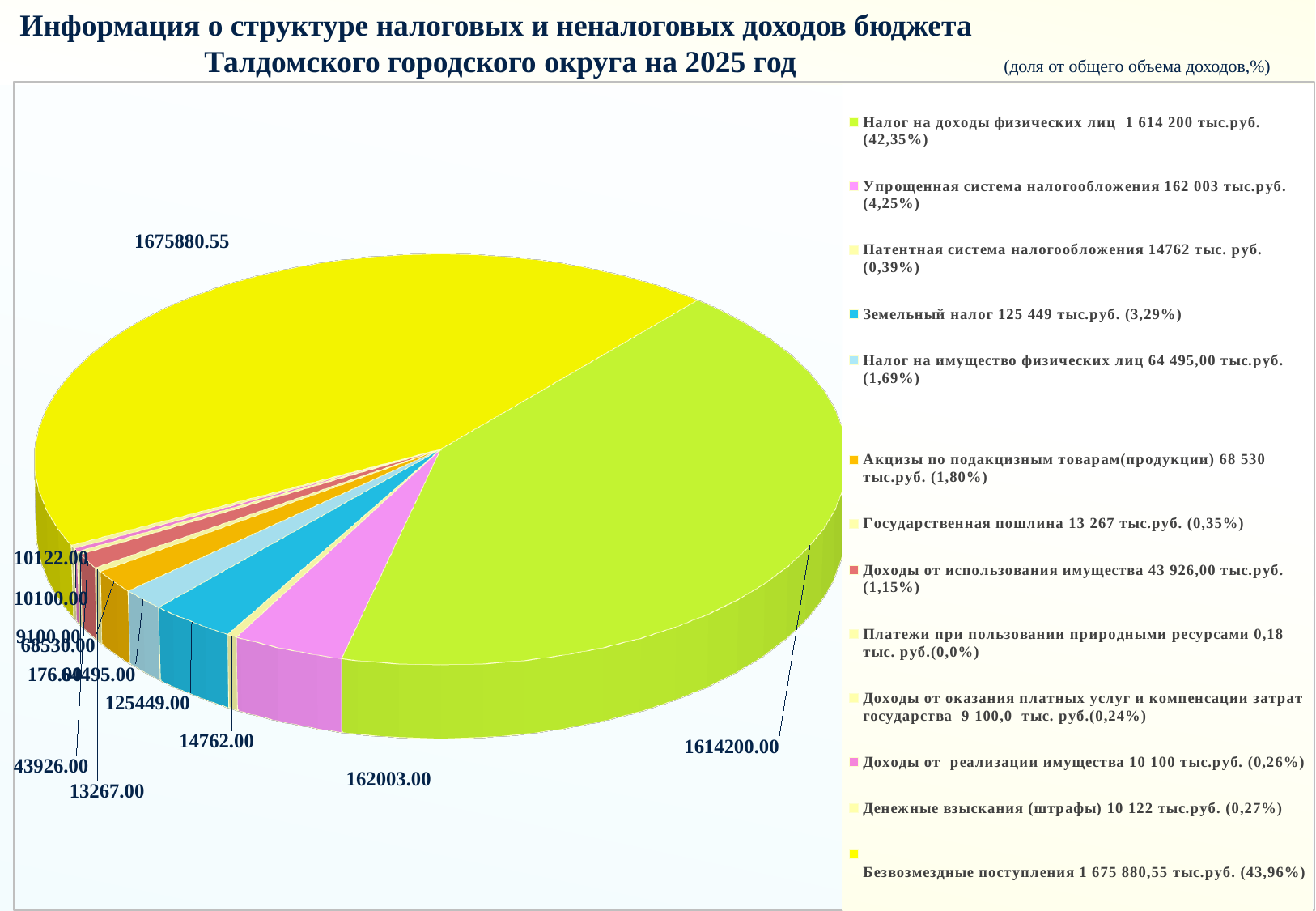
How many categories does the legend of the pie chart list? 13 What share of total revenue does Налог на доходы физических лиц represent according to the legend? 42,35% Which is larger: Акцизы по подакцизным товарам or Налог на имущество физических лиц? Акцизы по подакцизным товарам What is the data label value for Земельный налог? 125449.00 Which category has the smallest value according to the legend? Платежи при пользовании природными ресурсами What is the difference between the data labels for Безвозмездные поступления (1675880.55) and Налог на доходы физических лиц (1614200.00)? 61680.55 What year does the chart title say the budget revenue structure refers to? 2025 What is the data label value for Государственная пошлина? 13267.00 What kind of chart is shown on the slide? Pie chart What is the difference between the data labels for Упрощенная система налогообложения (162003.00) and Земельный налог (125449.00)? 36554.00 What share of total revenue does Безвозмездные поступления represent according to the legend? 43,96% Which category has the largest slice of the pie? Безвозмездные поступления